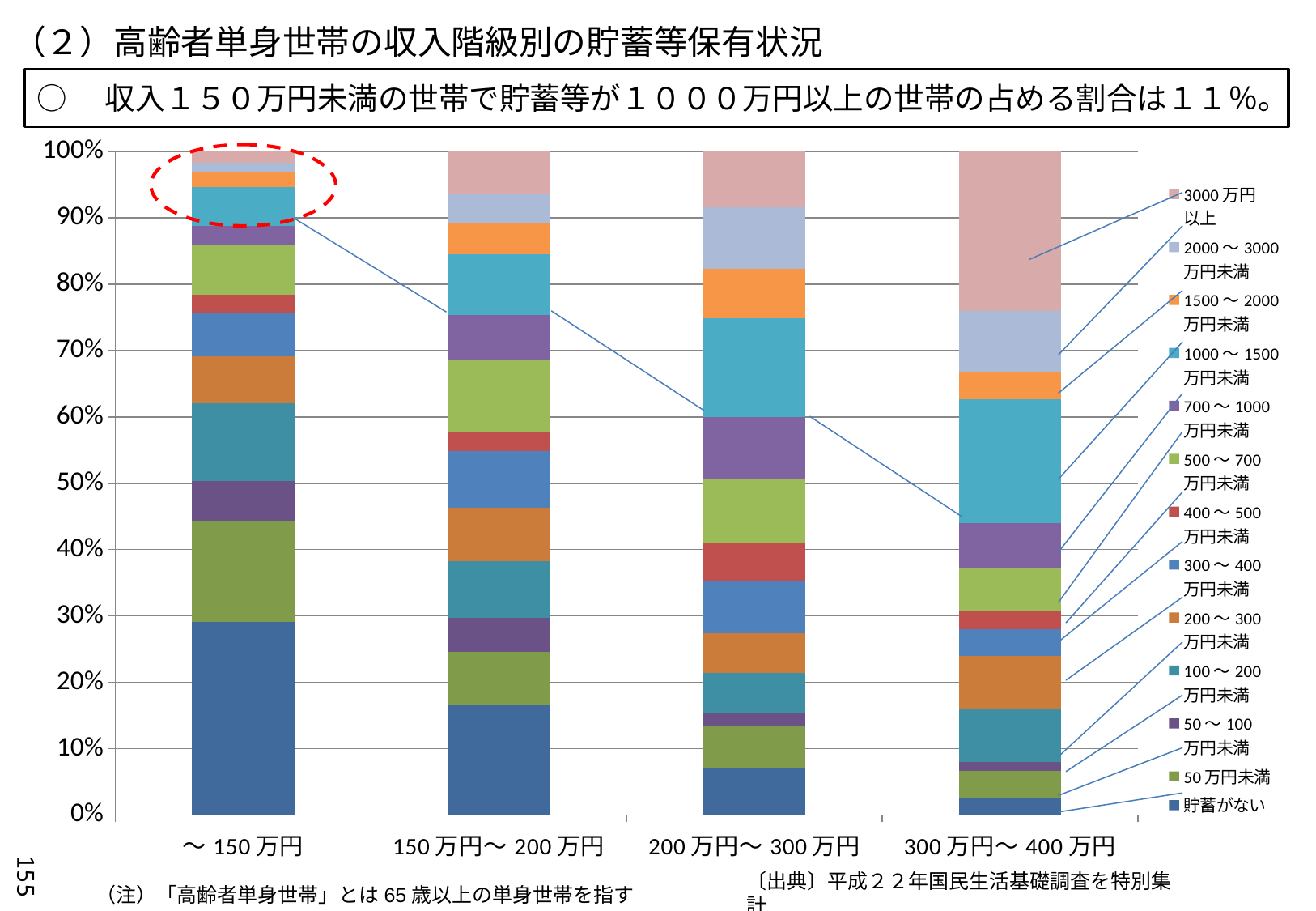
How many series does the legend list? 13 Which income category has the largest 3000万円以上 segment? 300万円～400万円 Is the 貯蓄がない share for ～150万円 greater or less than 20%? greater Which income category has the smallest 貯蓄がない segment? 300万円～400万円 What does each stacked bar total? 100% As income rises from left to right, does the 貯蓄がない share rise or fall? Fall What kind of chart is shown on the slide? Stacked bar chart Which income category has the largest 貯蓄がない segment? ～150万円 Is the 貯蓄がない share for 300万円～400万円 greater or less than 10%? less Which has a larger 貯蓄がない share, ～150万円 or 150万円～200万円? ～150万円 According to the slide text, what share of households with income under 150万円 have savings of 1000万円 or more? 11% How many income categories are shown on the x axis? 4